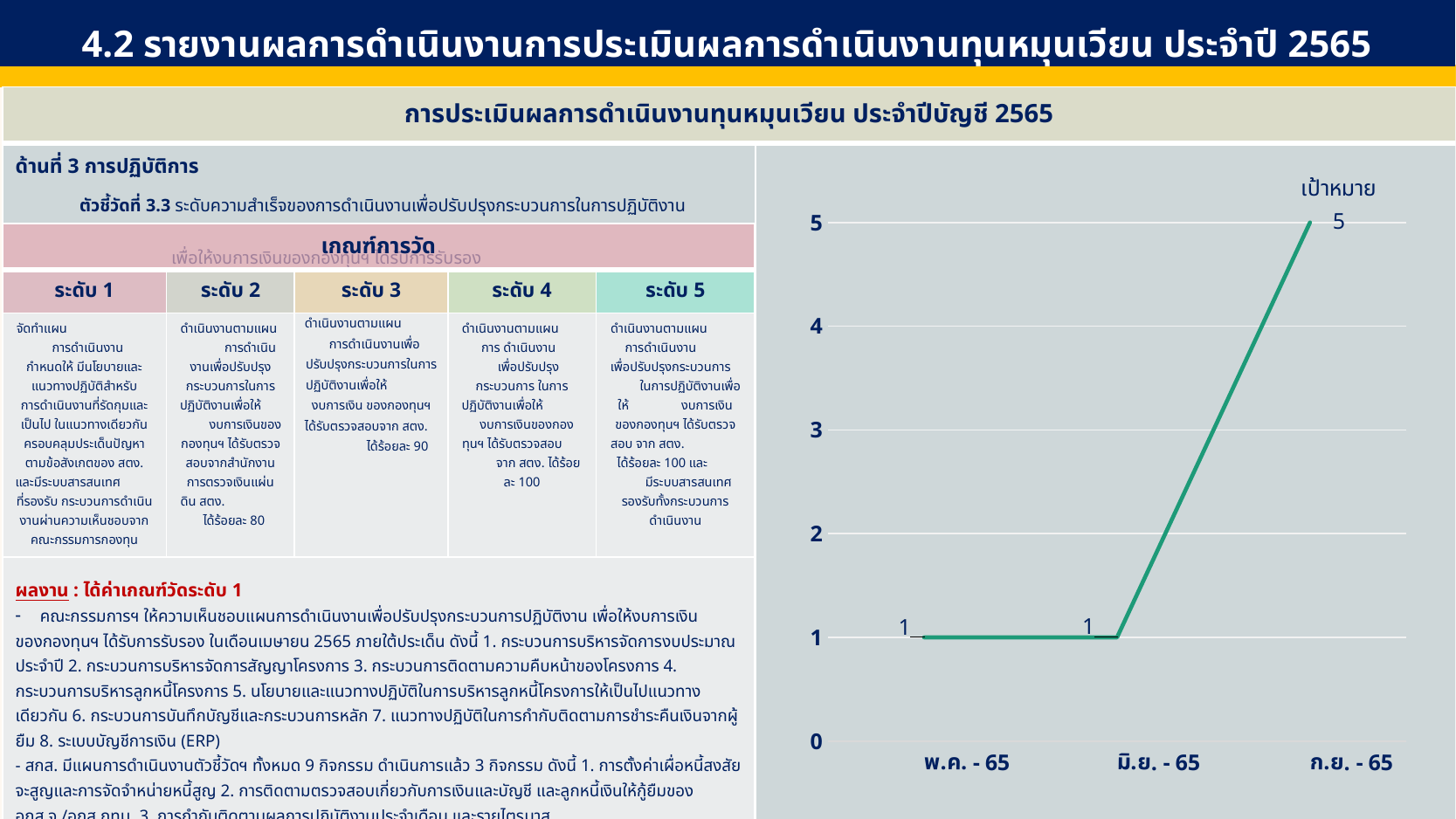
How many points are plotted on the line chart? 3 What is the value plotted for พ.ค. - 65? 1 What is the value plotted for มิ.ย. - 65? 1 Is the value for ก.ย. - 65 greater or less than 4? greater What label is written above the point for ก.ย. - 65 on the line chart? เป้าหมาย What is the value plotted for ก.ย. - 65? 5 What is the highest tick value shown on the y axis of the line chart? 5 What kind of chart is shown on the right side of the slide? line chart Do the values rise or fall from มิ.ย. - 65 to ก.ย. - 65? rise Which category has the highest value on the line chart? ก.ย. - 65 What is the difference between the values for ก.ย. - 65 and มิ.ย. - 65? 4 Which is larger, the value for พ.ค. - 65 or the value for ก.ย. - 65? ก.ย. - 65